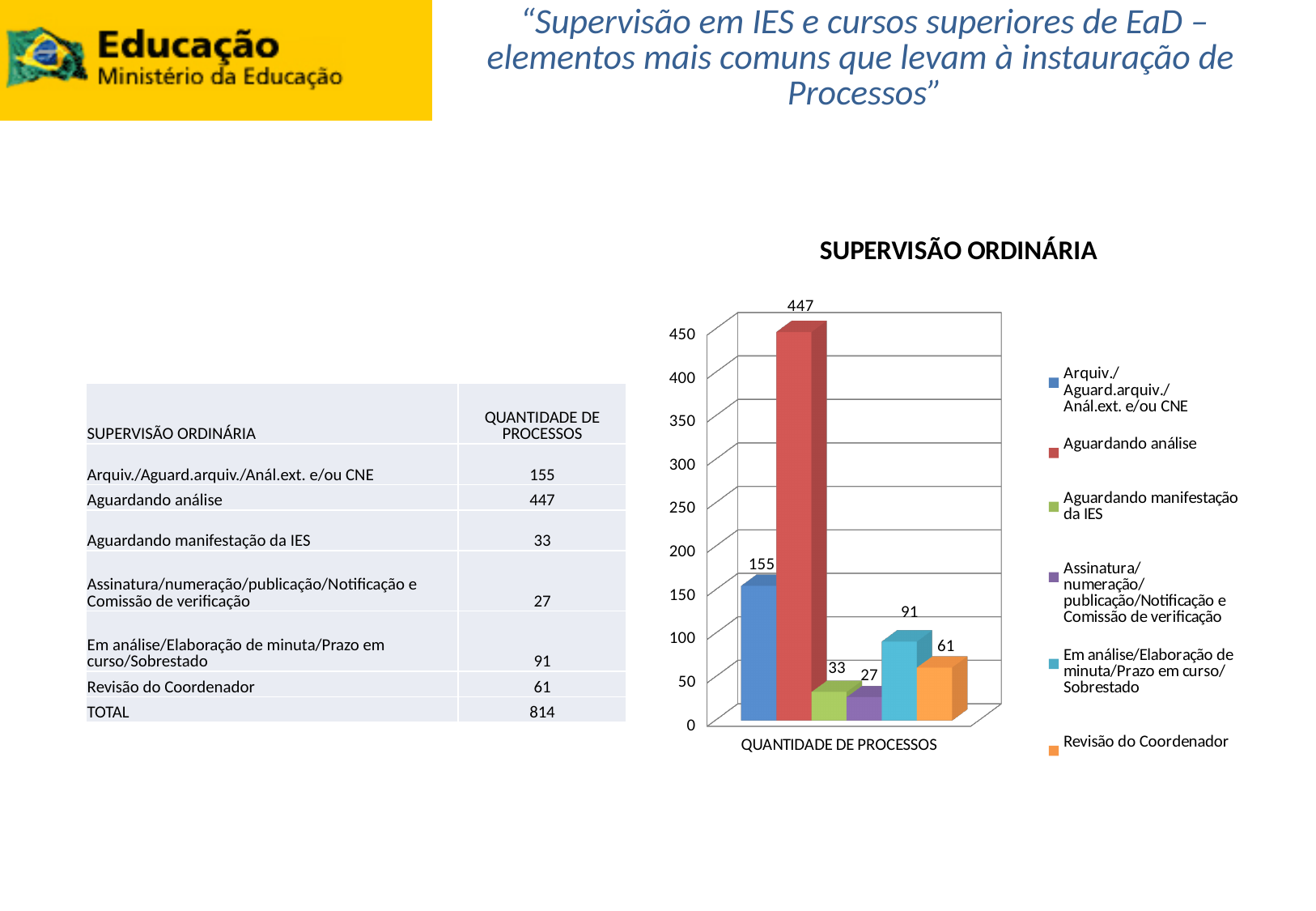
Which series has the highest value in the SUPERVISÃO ORDINÁRIA chart? Aguardando análise What is the value for Aguardando análise in the SUPERVISÃO ORDINÁRIA chart? 447 What kind of chart is the SUPERVISÃO ORDINÁRIA chart? bar chart What is the value for Aguardando manifestação da IES in the chart? 33 What is the difference between the values for Aguardando análise and Arquiv./Aguard.arquiv./Anál.ext. e/ou CNE? 292 Is the value for Arquiv./Aguard.arquiv./Anál.ext. e/ou CNE greater or less than 150? greater How many series does the legend of the SUPERVISÃO ORDINÁRIA chart list? 6 Which is larger: the value for Em análise/Elaboração de minuta/Prazo em curso/Sobrestado or the value for Revisão do Coordenador? Em análise/Elaboração de minuta/Prazo em curso/Sobrestado What is the value for Revisão do Coordenador in the SUPERVISÃO ORDINÁRIA chart? 61 What is the title of the chart on the slide? SUPERVISÃO ORDINÁRIA What is the category label shown on the x axis of the chart? QUANTIDADE DE PROCESSOS Which series has the lowest value in the SUPERVISÃO ORDINÁRIA chart? Assinatura/numeração/publicação/Notificação e Comissão de verificação